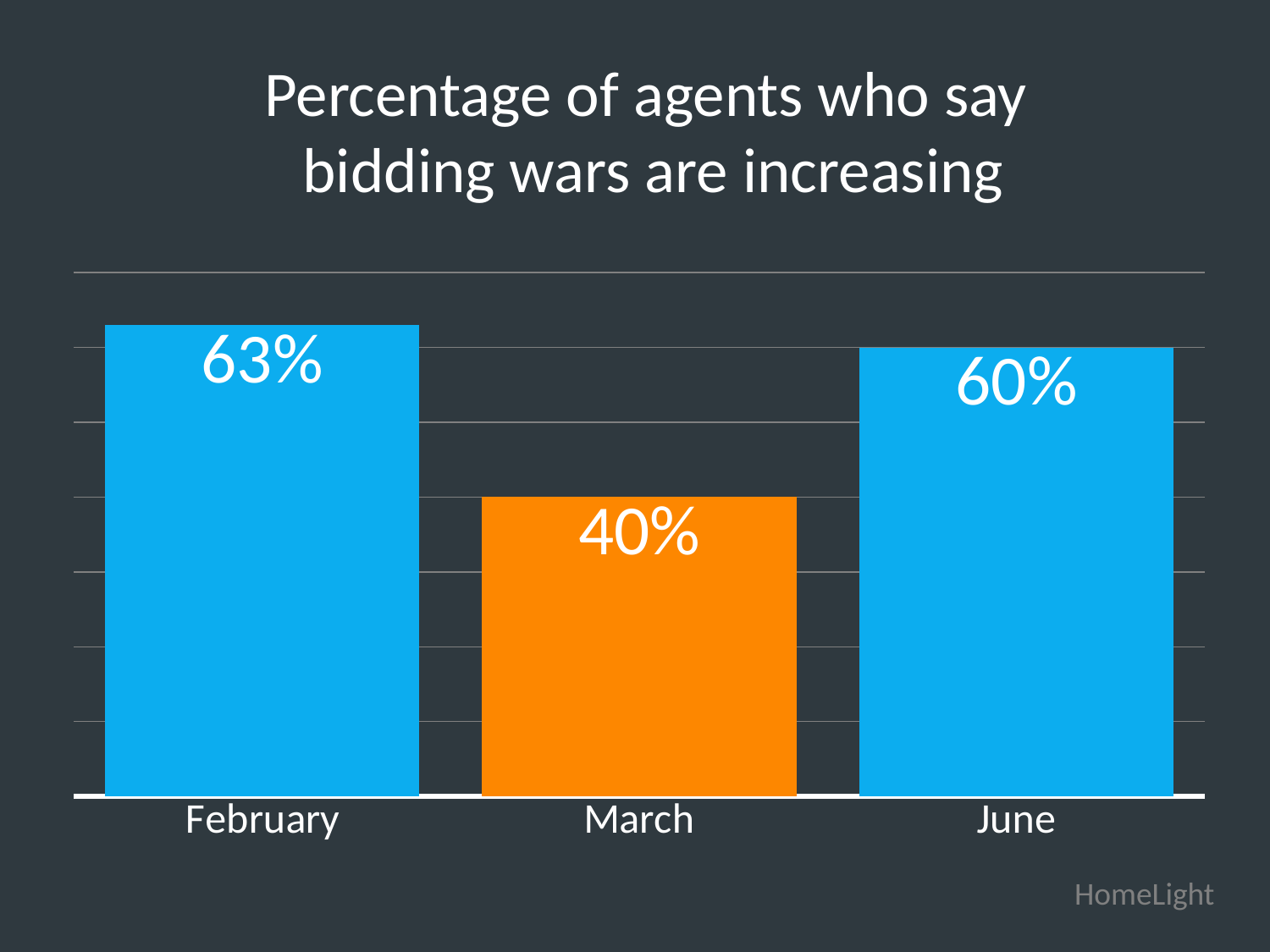
Which is larger, the percentage for March or the percentage for June? June What percentage of agents said bidding wars are increasing in February? 63% What is the title of the chart? Percentage of agents who say bidding wars are increasing What percentage of agents said bidding wars are increasing in June? 60% How many months are shown on the chart? 3 Which month's bar is coloured orange? March What percentage of agents said bidding wars are increasing in March? 40% Which month has the highest percentage of agents saying bidding wars are increasing? February Which month has the lowest percentage of agents saying bidding wars are increasing? March What is the difference between the June and March percentages? 20% What is the difference between the February and March percentages? 23% What kind of chart is shown on the slide? Bar chart